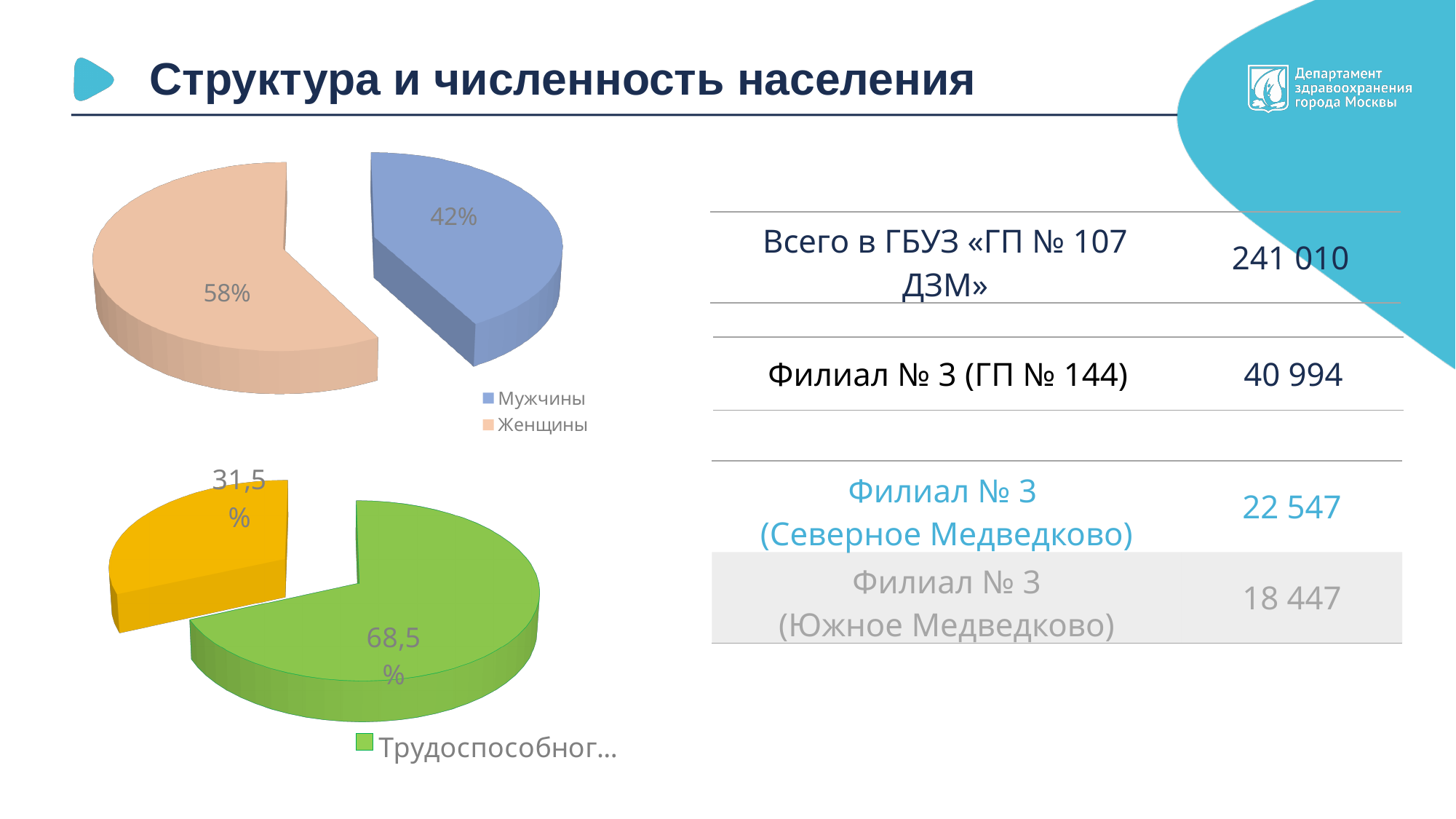
In the bottom pie chart, what is the difference between the green slice's share and the yellow slice's share? 37% How many entries does the legend of the top chart list? 2 How many slices does the bottom pie chart have? 2 In the bottom pie chart, what share is shown on the yellow slice? 31,5% In the bottom pie chart, which slice is larger, the green one or the yellow one? green In the top pie chart, what is the difference between the Женщины share and the Мужчины share? 16% In the top pie chart, what share is shown for Мужчины? 42% In the top pie chart, which slice is larger, Мужчины or Женщины? Женщины What kind of chart is the top chart on the slide? pie chart In the top pie chart, which colour represents Женщины? peach (light orange) In the bottom pie chart, what share is shown on the green slice? 68,5%